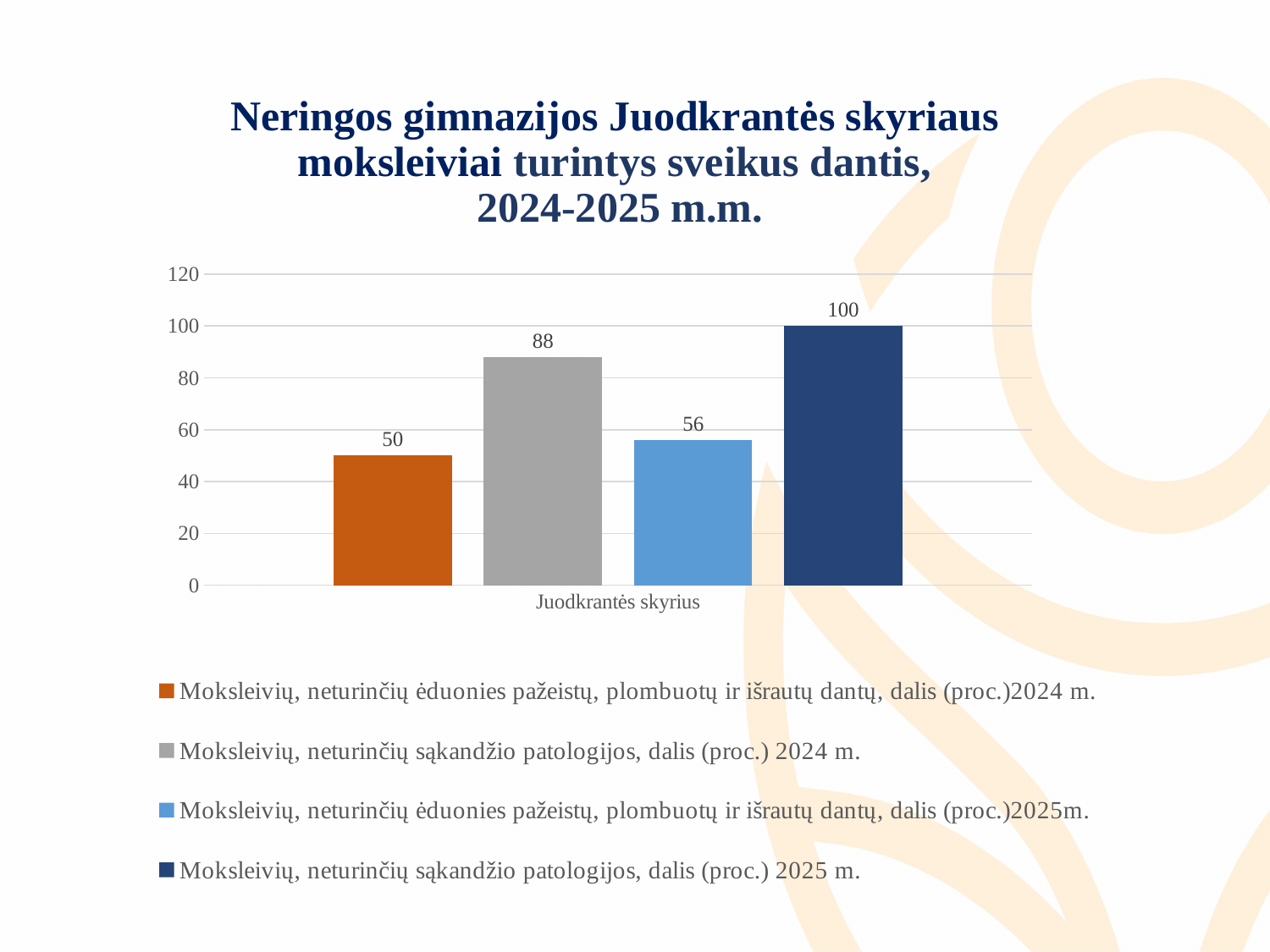
What is the difference between the 2025 and 2024 values for 'Moksleivių, neturinčių sąkandžio patologijos'? 12 Which is larger: the 2024 value for 'neturinčių sąkandžio patologijos' or the 2025 value for 'neturinčių ėduonies pažeistų, plombuotų ir išrautų dantų'? Moksleivių, neturinčių sąkandžio patologijos, dalis (proc.) 2024 m. Which series has the highest value? Moksleivių, neturinčių sąkandžio patologijos, dalis (proc.) 2025 m. What is the value for 'Moksleivių, neturinčių ėduonies pažeistų, plombuotų ir išrautų dantų, dalis (proc.)2024 m.'? 50 What is the difference between the 2025 and 2024 values for 'Moksleivių, neturinčių ėduonies pažeistų, plombuotų ir išrautų dantų'? 6 What is the category label shown on the x axis? Juodkrantės skyrius Which series has the lowest value? Moksleivių, neturinčių ėduonies pažeistų, plombuotų ir išrautų dantų, dalis (proc.)2024 m. What kind of chart is shown on the slide? Bar chart What is the value for 'Moksleivių, neturinčių sąkandžio patologijos, dalis (proc.) 2024 m.'? 88 How many series does the legend list? 4 What is the value for 'Moksleivių, neturinčių sąkandžio patologijos, dalis (proc.) 2025 m.'? 100 What is the value for 'Moksleivių, neturinčių ėduonies pažeistų, plombuotų ir išrautų dantų, dalis (proc.)2025m.'? 56